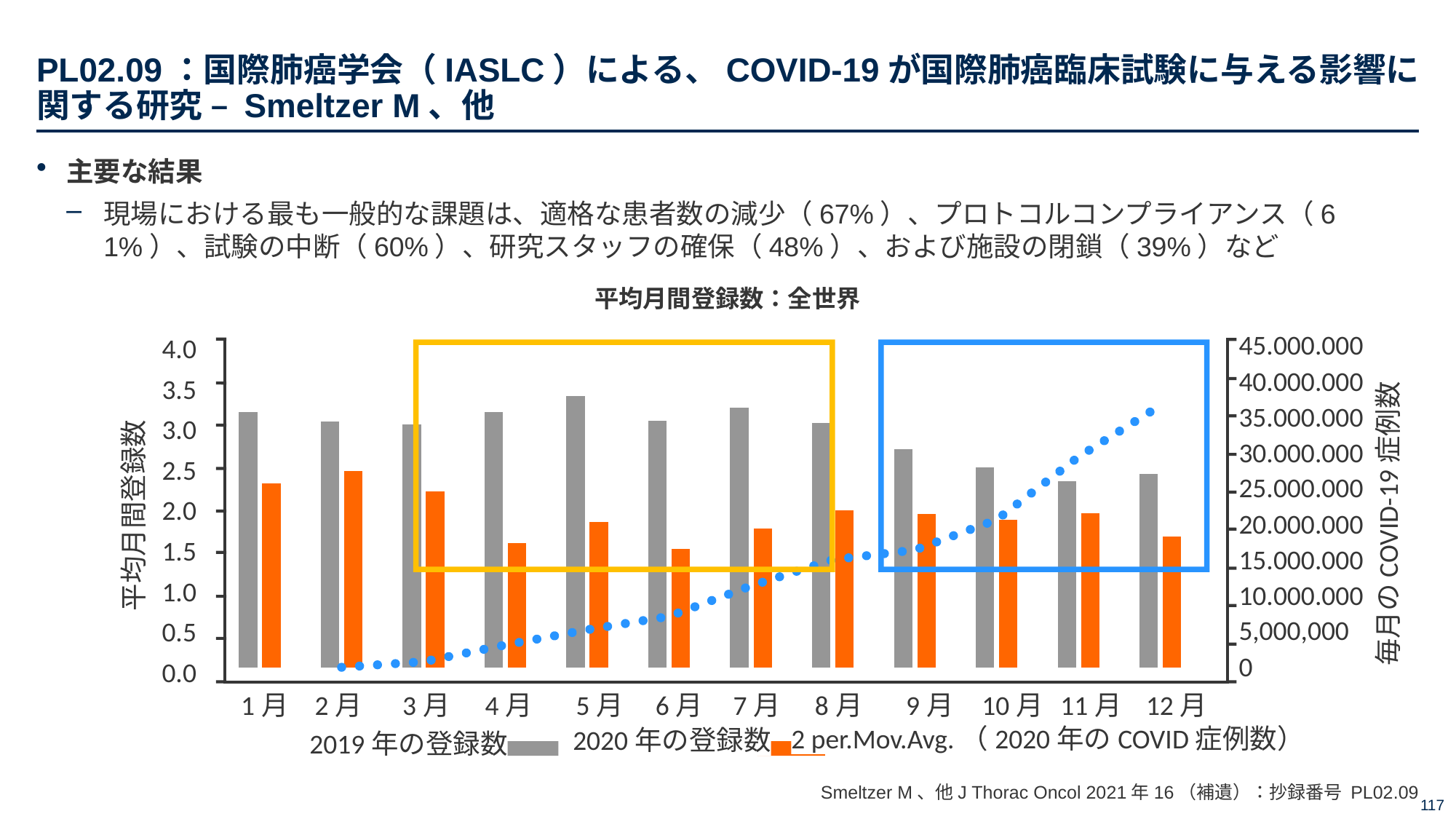
Is the 2019 年の登録数 value for 11 月 greater or less than 2.5? less What is the label of the right-hand vertical axis? 毎月の COVID-19 症例数 For 1 月, which is larger: the 2019 年の登録数 or the 2020 年の登録数? 2019 年の登録数 Which month has the highest 2020 年の登録数 (orange bar)? 2 月 How many series does the chart legend list? 3 Which month has the highest 2019 年の登録数 (gray bar)? 5 月 Is the 2020 年の登録数 value for 6 月 greater or less than 2.0? less Is the 2019 年の登録数 value for 1 月 greater or less than 3.0? greater Does the dotted line (2 per. Mov. Avg. of 2020 COVID cases) rise or fall from 1 月 to 12 月? Rise What is the title of the chart? 平均月間登録数：全世界 How many months are shown on the x axis of the chart? 12 What kind of chart is shown on the slide? Bar chart (with a dotted line series)